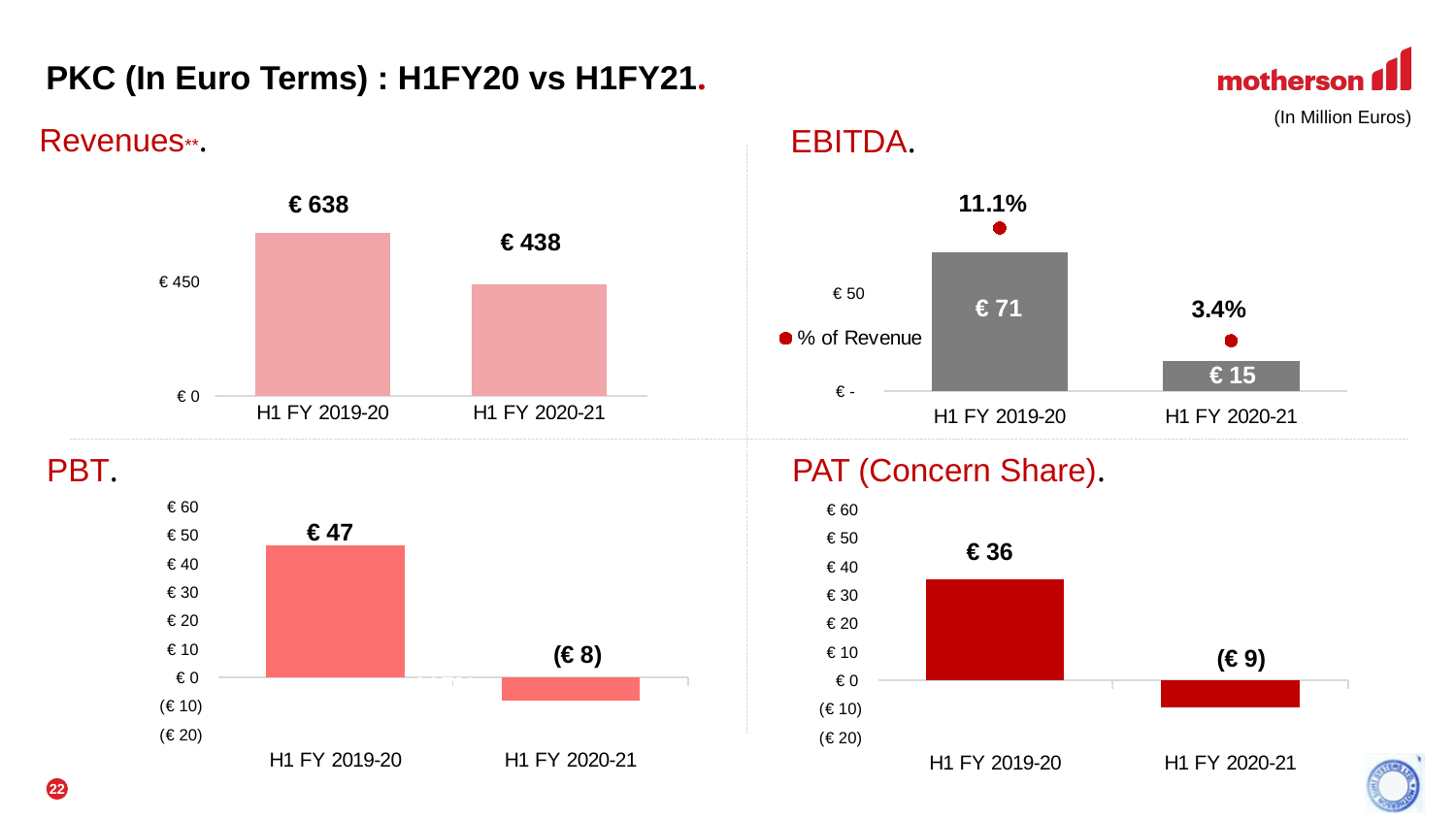
In the PAT (Concern Share) chart, what is the value for H1 FY 2019-20? € 36 How many categories are shown on the x axis of the Revenues chart? 2 In the Revenues chart, what is the difference between the H1 FY 2019-20 and H1 FY 2020-21 values? € 200 What kind of chart is the Revenues chart? bar chart In the EBITDA chart, which period has the larger value, H1 FY 2019-20 or H1 FY 2020-21? H1 FY 2019-20 In the PBT chart, what is the value for H1 FY 2020-21? (€ 8) In the PBT chart, is the value for H1 FY 2019-20 greater or less than € 40? greater In the EBITDA chart, what is the value for H1 FY 2020-21? € 15 In the EBITDA chart, what does the legend entry with the red dot marker represent? % of Revenue In the PAT (Concern Share) chart, do the values rise or fall from H1 FY 2019-20 to H1 FY 2020-21? fall In the Revenues chart, what is the value for H1 FY 2019-20? € 638 In the EBITDA chart, what is the % of Revenue shown for H1 FY 2019-20? 11.1%